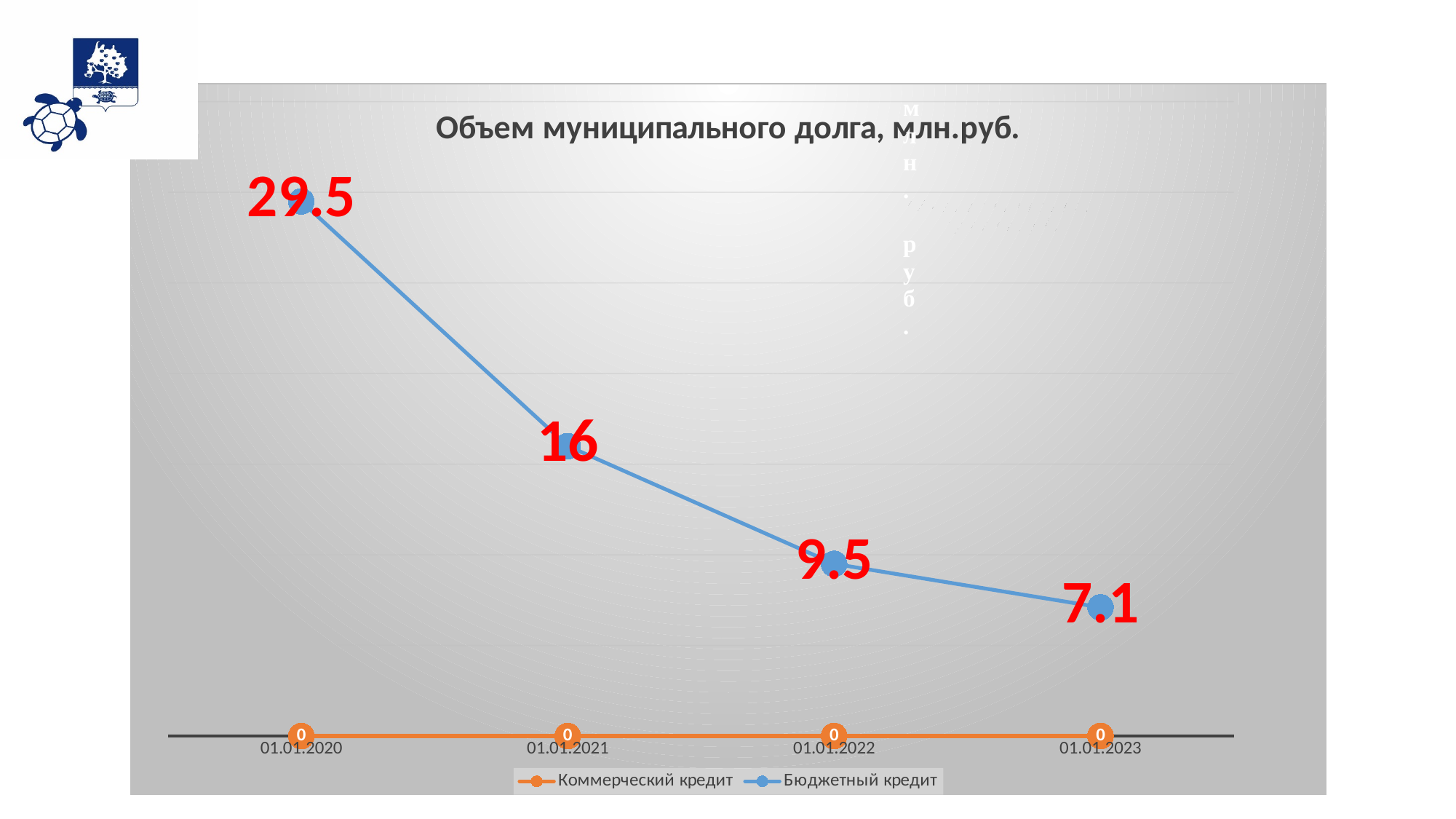
What is the difference between Бюджетный кредит on 01.01.2022 and on 01.01.2023? 2.4 How many dates are shown on the x axis? 4 What is the difference between Бюджетный кредит on 01.01.2020 and on 01.01.2021? 13.5 What is the value of Бюджетный кредит on 01.01.2020? 29.5 On which date is Бюджетный кредит highest? 01.01.2020 On which date is Бюджетный кредит lowest? 01.01.2023 What is the value of Коммерческий кредит on 01.01.2021? 0 What kind of chart is this? line chart How many series does the legend list? 2 What is the value of Бюджетный кредит on 01.01.2022? 9.5 Which is larger: Бюджетный кредит on 01.01.2021 or on 01.01.2022? 01.01.2021 Does Бюджетный кредит rise or fall from 01.01.2020 to 01.01.2023? fall